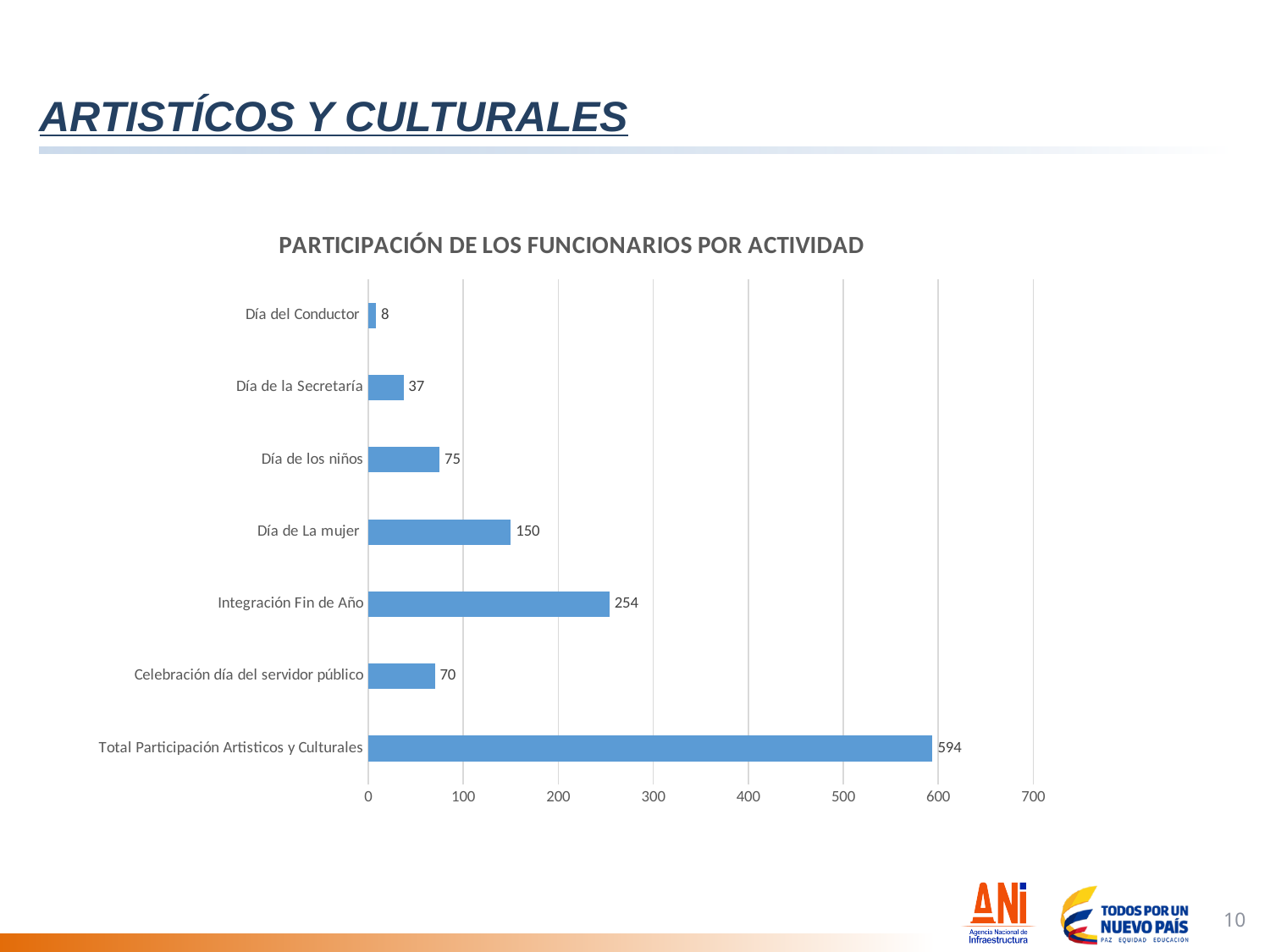
What is the value for Integración Fin de Año? 254 What is the difference between the values for Día de los niños and Día de la Secretaría? 38 Is the value for Integración Fin de Año greater or less than 200? greater Which is larger, the value for Día de los niños or the value for Celebración día del servidor público? Día de los niños What kind of chart is shown on the slide? Bar chart How many categories are shown in the chart? 7 What is the value for Celebración día del servidor público? 70 What is the title of the chart? PARTICIPACIÓN DE LOS FUNCIONARIOS POR ACTIVIDAD What is the value for Total Participación Artisticos y Culturales? 594 Excluding the total bar, which activity has the highest participation? Integración Fin de Año Which category has the lowest value? Día del Conductor What is the value for Día de La mujer? 150